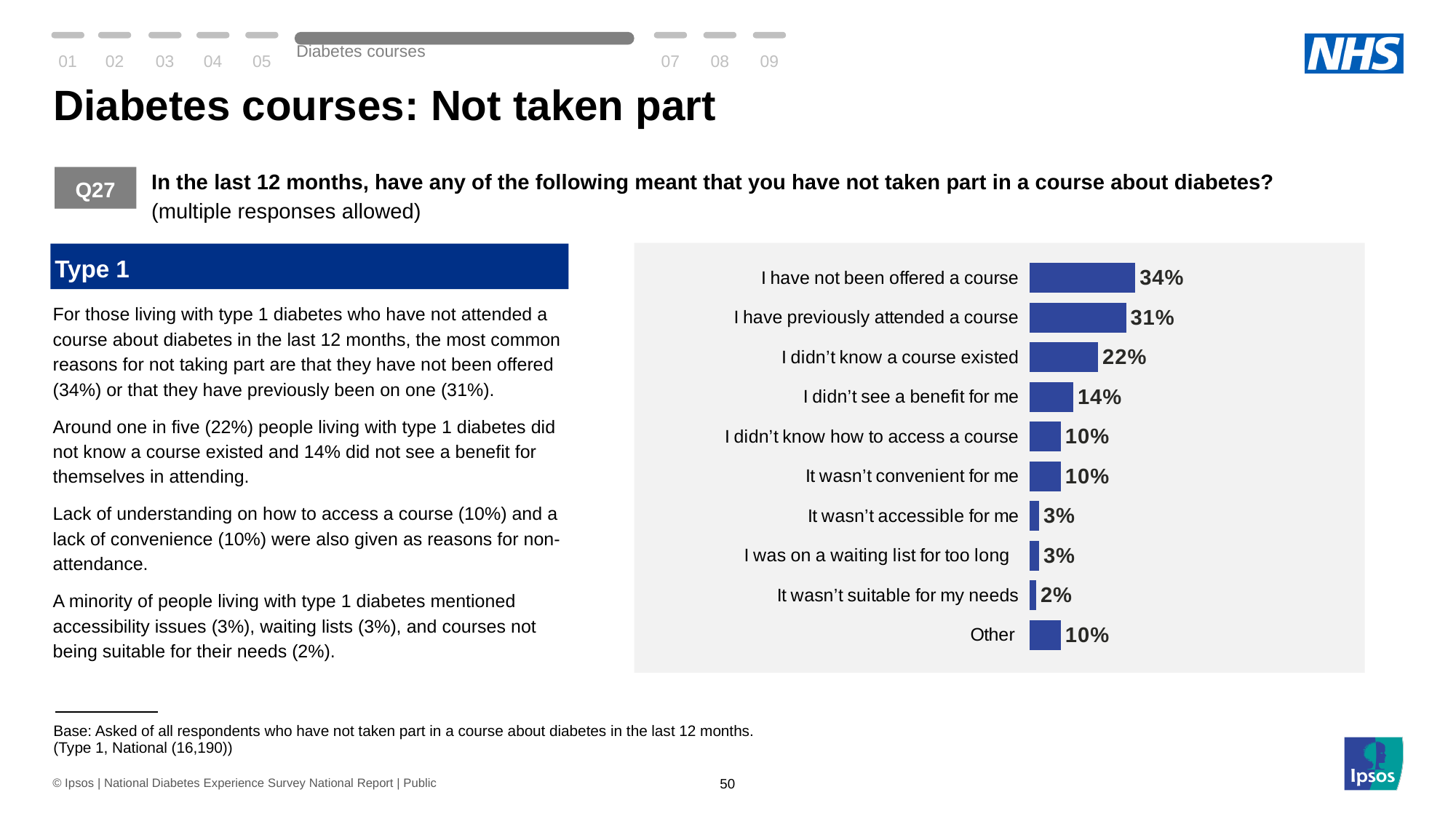
Which diabetes type does the chart on this slide cover? Type 1 What is the difference between 'I didn't know a course existed' and 'I didn't see a benefit for me'? 8 percentage points What is the value for 'Other'? 10% What is the difference between 'I have not been offered a course' and 'I have previously attended a course'? 3 percentage points What is the value for 'I didn't know a course existed'? 22% How many reasons (categories) are shown in the chart? 10 Which is larger: 'I didn't see a benefit for me' or 'It wasn't convenient for me'? I didn't see a benefit for me Which reason has the lowest percentage? It wasn't suitable for my needs What percentage of respondents said 'I have not been offered a course'? 34% What kind of chart is shown on the slide? Bar chart What percentage is shown for 'It wasn't suitable for my needs'? 2% Which reason has the highest percentage? I have not been offered a course